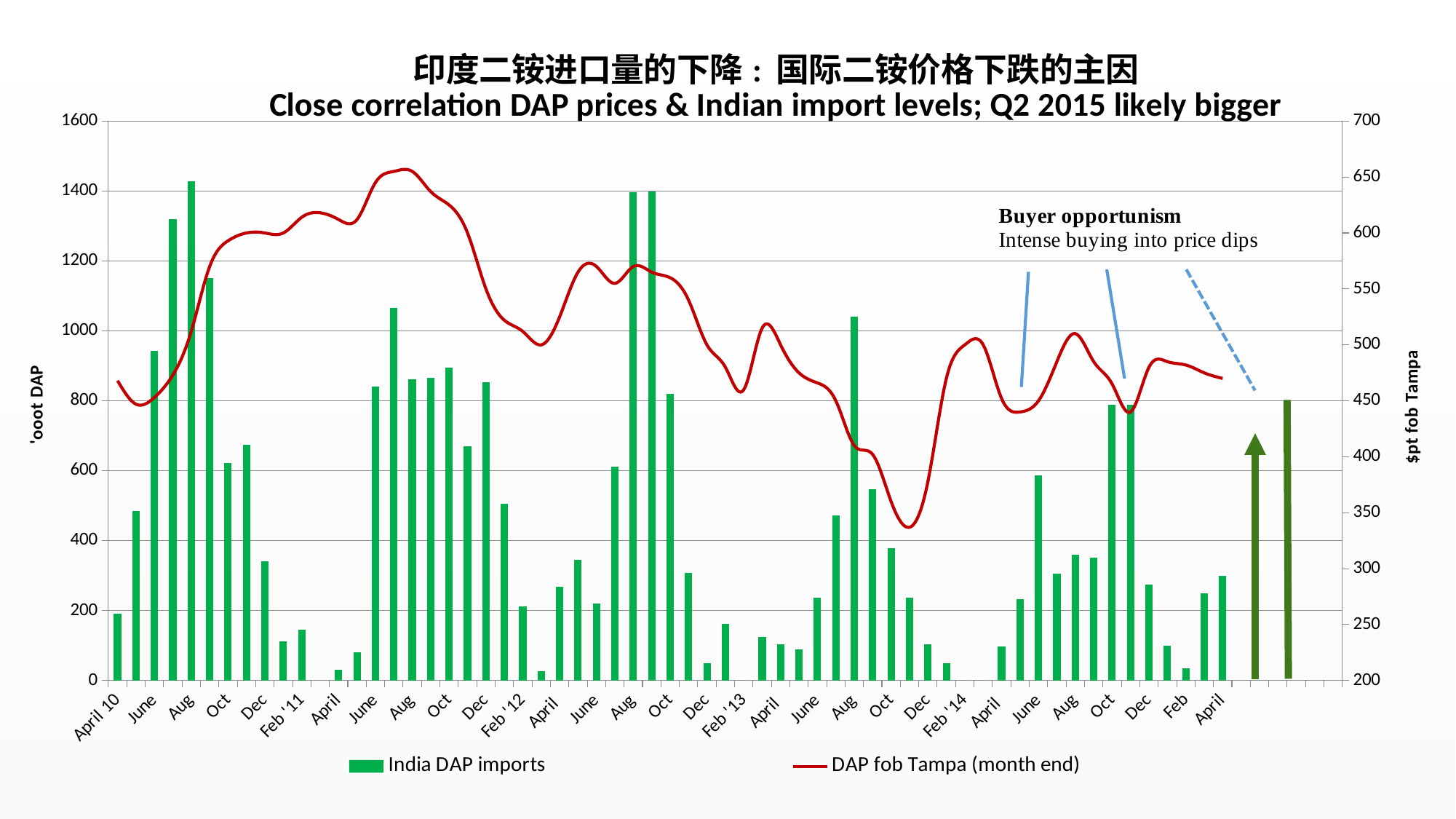
What is the title of the right-hand vertical axis? $pt fob Tampa Is the India DAP imports value for Oct '11 greater or less than 800? greater Is the India DAP imports value for Aug 2010 greater or less than 1400? greater Is the India DAP imports value for Feb '14 greater or less than 200? less What kind of chart is shown on the slide? A combined bar and line chart Does the DAP fob Tampa line rise or fall between Aug '12 and Dec '13? Fall Which is larger, the India DAP imports bar for Aug '12 or the bar for Aug '13? Aug '12 How many series does the legend list? 2 Which series is drawn as a red line? DAP fob Tampa (month end)